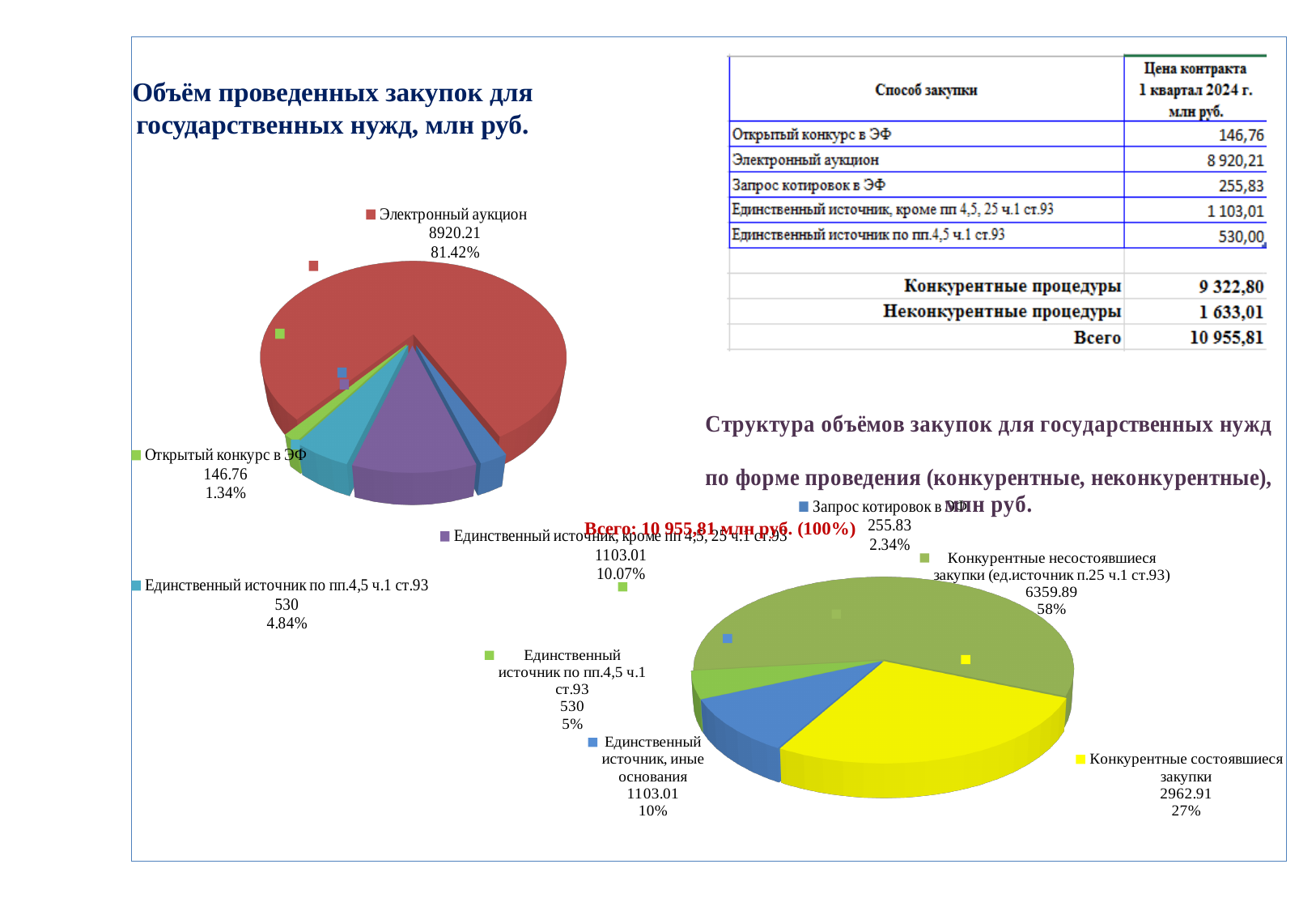
In the chart titled "Объём проведенных закупок для государственных нужд, млн руб.", what value is shown for Электронный аукцион? 8920.21 What kind of chart is the one titled "Структура объёмов закупок для государственных нужд по форме проведения"? Pie chart In the chart titled "Объём проведенных закупок для государственных нужд, млн руб.", what is the difference between the values for Запрос котировок в ЭФ and Открытый конкурс в ЭФ? 109.07 In the chart titled "Структура объёмов закупок для государственных нужд по форме проведения", what colour is the slice for Конкурентные состоявшиеся закупки? Yellow In the chart titled "Структура объёмов закупок для государственных нужд по форме проведения", what value is shown for Конкурентные состоявшиеся закупки? 2962.91 In the chart titled "Объём проведенных закупок для государственных нужд, млн руб.", which is larger: Единственный источник по пп.4,5 ч.1 ст.93 or Запрос котировок в ЭФ? Единственный источник по пп.4,5 ч.1 ст.93 In the chart titled "Объём проведенных закупок для государственных нужд, млн руб.", what percentage share does Открытый конкурс в ЭФ have? 1.34% In the chart titled "Объём проведенных закупок для государственных нужд, млн руб.", which category has the largest slice? Электронный аукцион In the chart titled "Объём проведенных закупок для государственных нужд, млн руб.", which category has the smallest slice? Открытый конкурс в ЭФ In the chart titled "Объём проведенных закупок для государственных нужд, млн руб.", how many slices does the pie have? 5 In the chart titled "Структура объёмов закупок для государственных нужд по форме проведения", how many slices does the pie have? 4 In the chart titled "Структура объёмов закупок для государственных нужд по форме проведения", what percentage share do Конкурентные несостоявшиеся закупки have? 58%